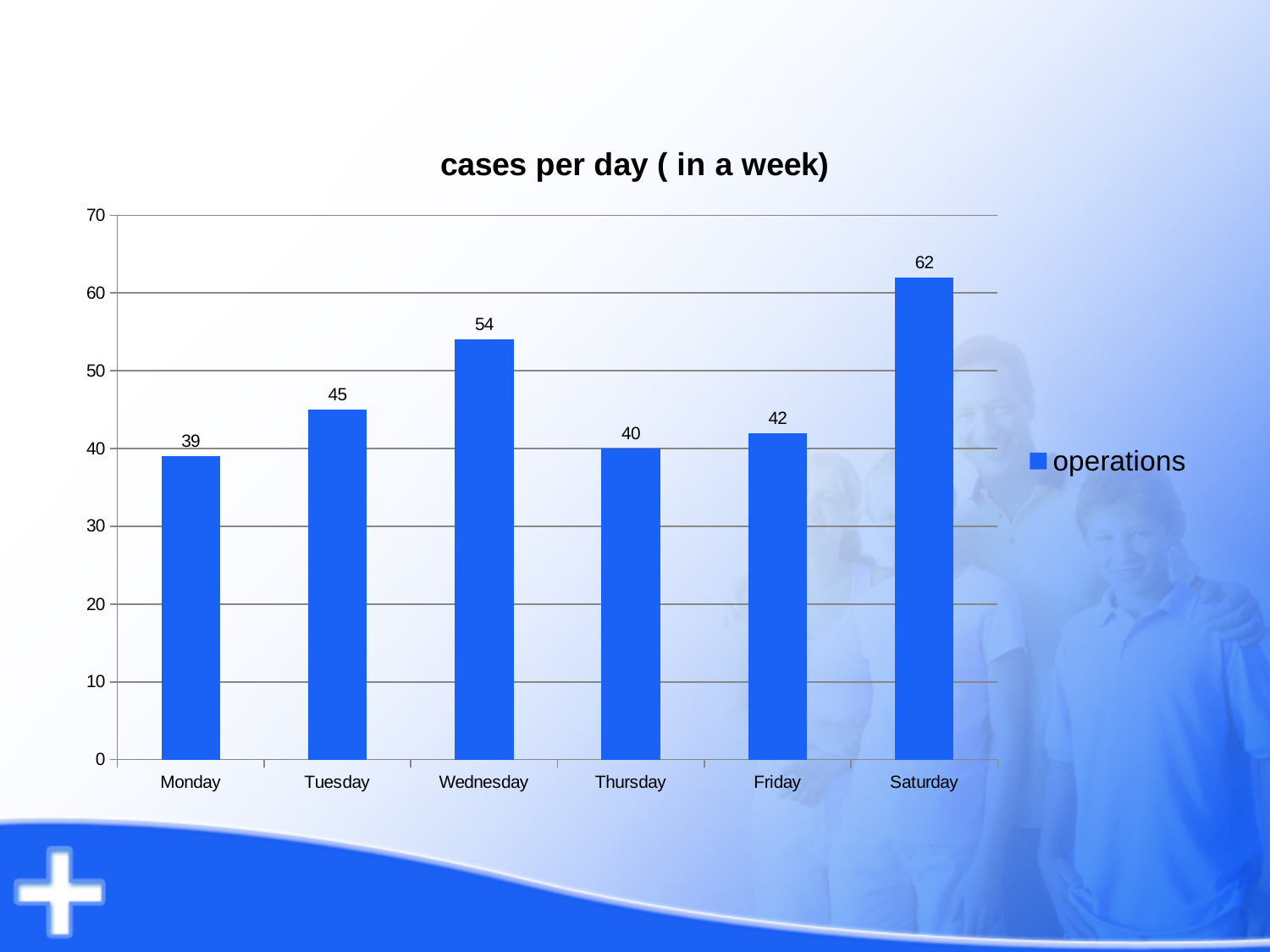
What is the value for Friday? 42 Which day has the lowest value? Monday What is the difference between the values for Wednesday and Thursday? 14 What is the title of the chart? cases per day ( in a week) What is the difference between the values for Saturday and Monday? 23 What is the value for Wednesday? 54 Is the value for Saturday greater or less than 60? greater How many days are shown on the x axis? 6 What is the value for Monday? 39 Which is larger, the value for Tuesday or the value for Friday? Tuesday What kind of chart is shown? bar chart Which day has the highest value? Saturday